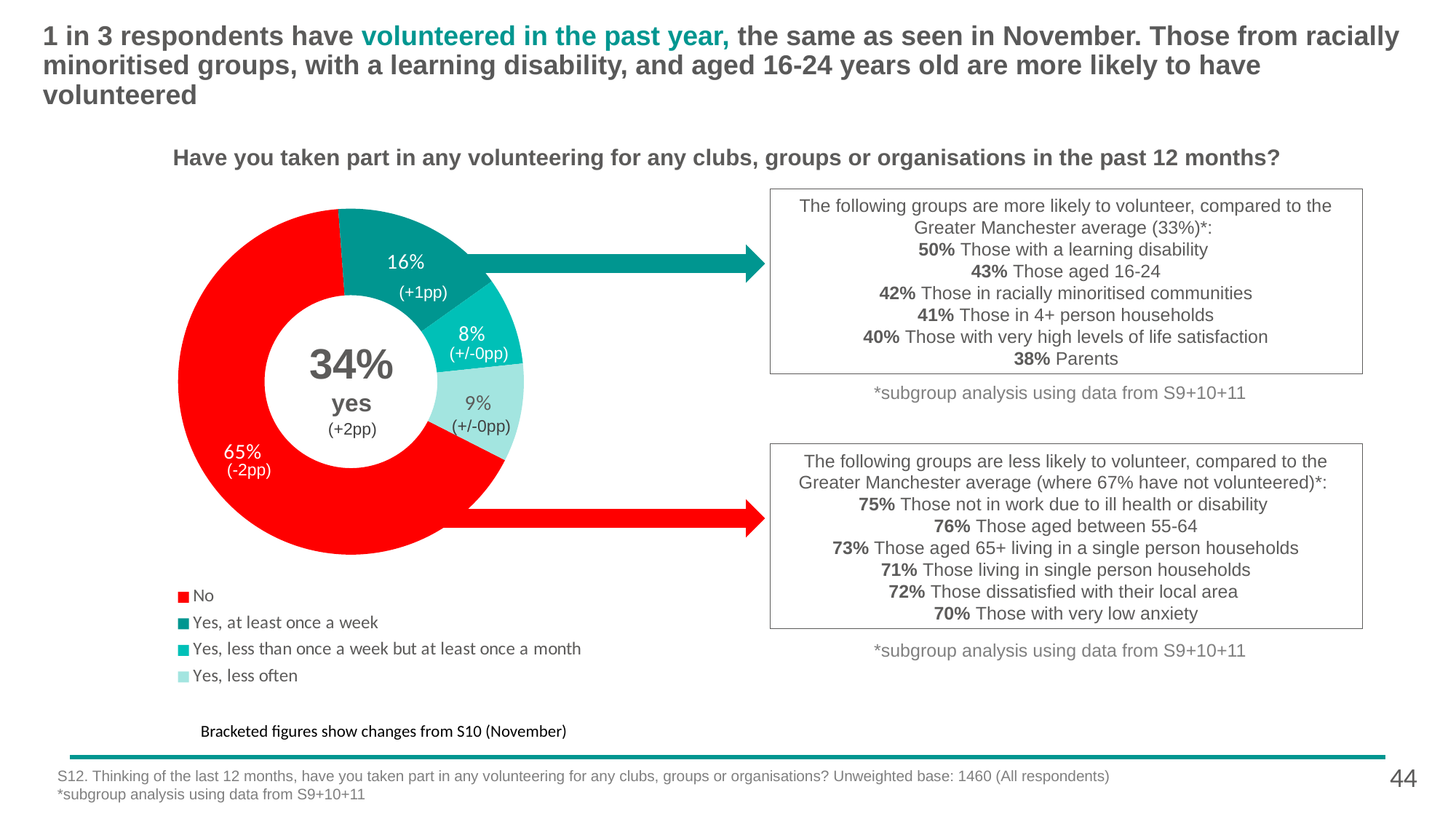
What type of chart is shown on the slide? Donut (pie) chart What overall percentage of respondents said "yes", as shown in the centre of the donut chart? 34% What percentage of respondents said "Yes, less than once a week but at least once a month"? 8% What percentage of respondents said "Yes, less often"? 9% Which category has the smallest share of the donut chart? Yes, less than once a week but at least once a month Which category has the largest share of the donut chart? No What is the difference in percentage points between the "No" slice and the "Yes, at least once a week" slice? 49pp What percentage of respondents said "Yes, at least once a week"? 16% How many categories does the legend of the donut chart list? 4 Which is larger: the share for "Yes, less often" or the share for "Yes, less than once a week but at least once a month"? Yes, less often What percentage of respondents answered "No" in the donut chart? 65% What change from November is shown in brackets for the "No" slice? -2pp